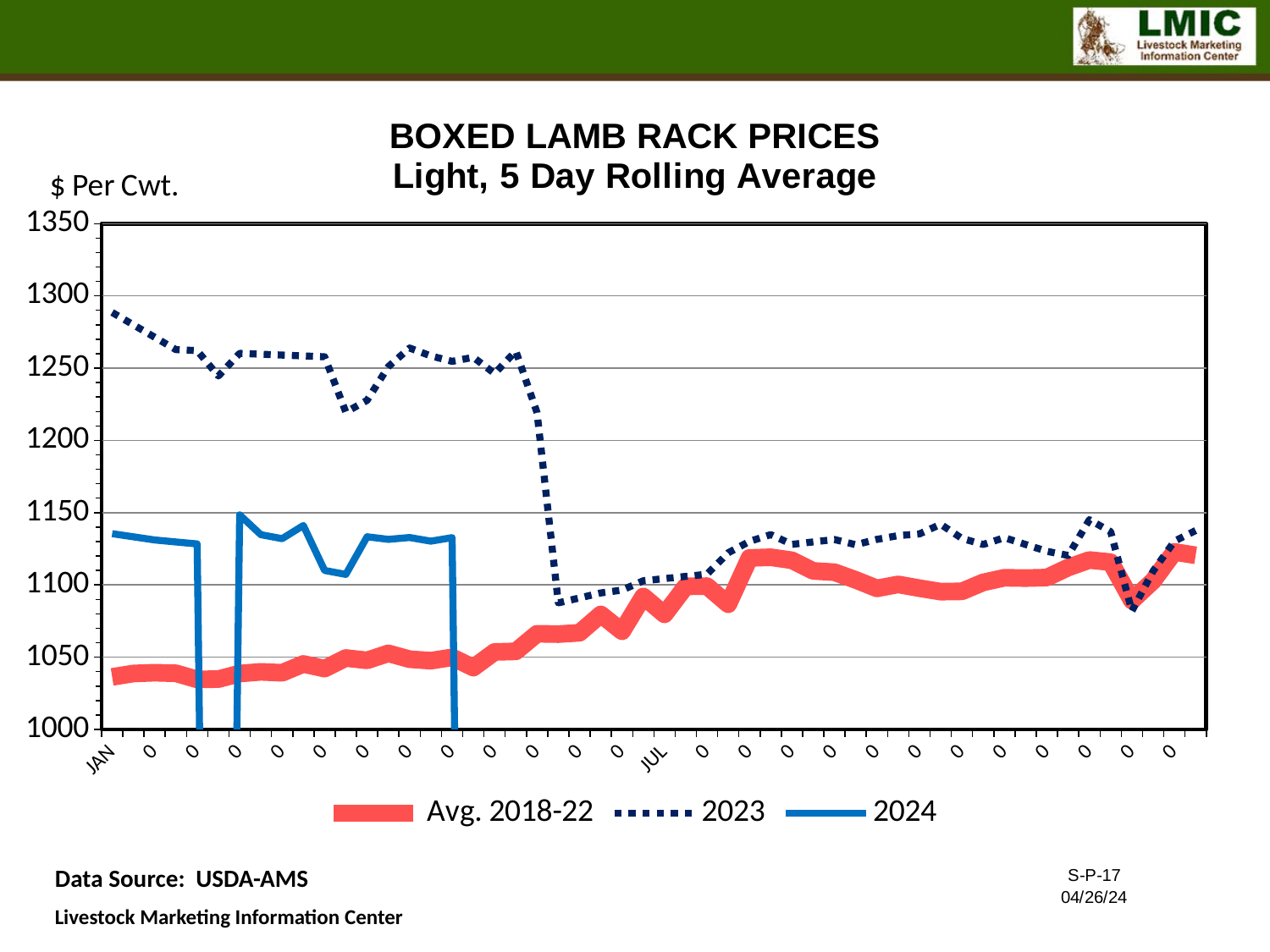
Is the value for the 2023 series at JAN greater or less than 1250? greater What kind of chart is shown on the slide? line chart Is the value for the 2024 series at JAN greater or less than 1150? less Does the 2023 series rise or fall from JAN to JUL? fall How many series does the legend list? 3 Which series has the lowest value at JAN? Avg. 2018-22 Which series has the highest value at JAN? 2023 At JAN, which is larger: the 2023 value or the 2024 value? 2023 Is the value for the Avg. 2018-22 series at JAN greater or less than 1050? less What unit label is shown on the vertical axis? $ Per Cwt. What is the title of the chart? BOXED LAMB RACK PRICES Light, 5 Day Rolling Average